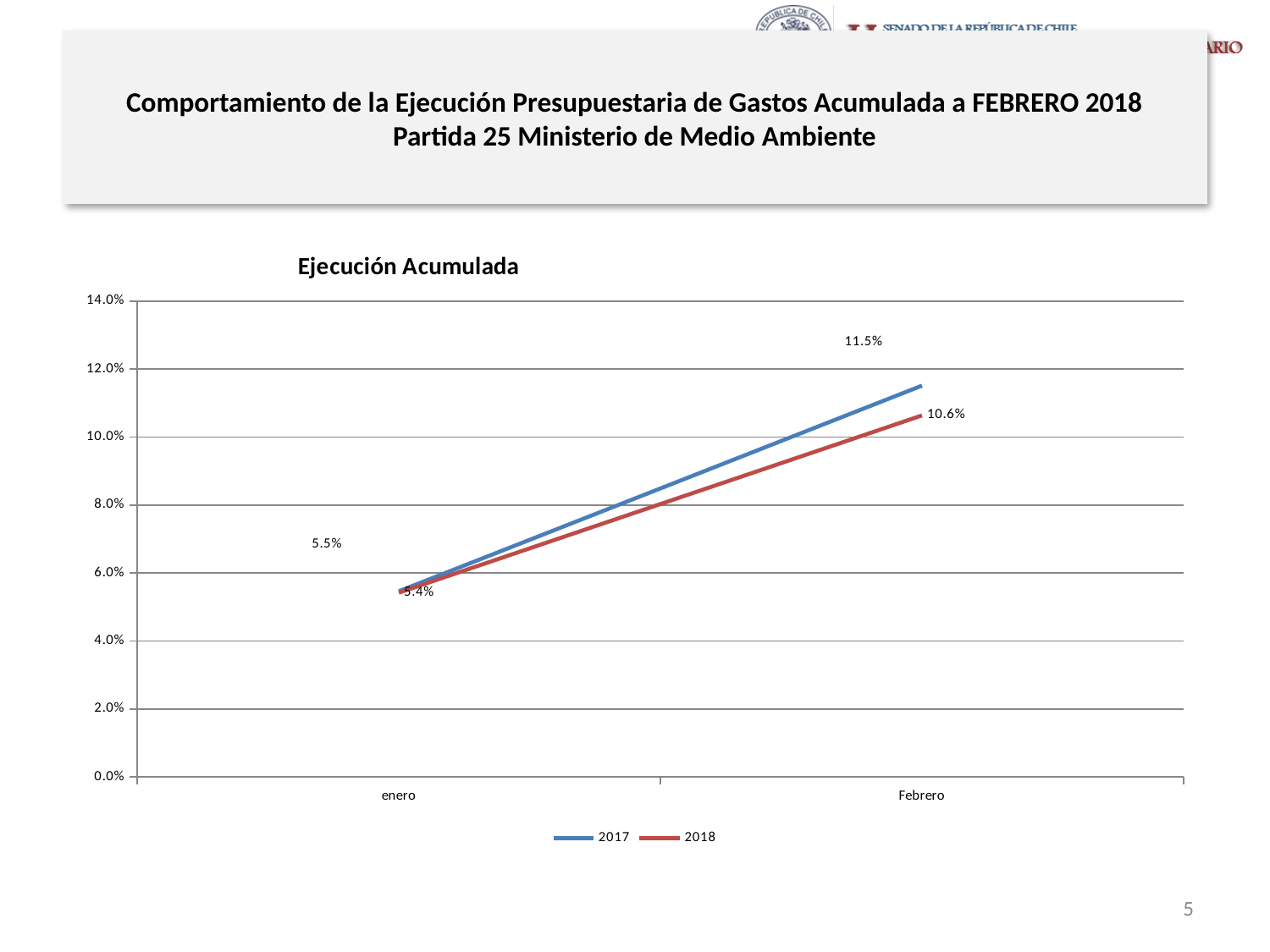
Do the values for the 2018 series rise or fall from enero to Febrero in the 'Ejecución Acumulada' chart? rise In Febrero, which series has the higher value in the 'Ejecución Acumulada' chart, 2017 or 2018? 2017 What is the difference between the 2017 and 2018 values in Febrero in the 'Ejecución Acumulada' chart? 0.9% What is the value for 2017 in enero in the 'Ejecución Acumulada' chart? 5.5% Is the value for 2018 in Febrero greater or less than 12.0% in the 'Ejecución Acumulada' chart? less How many series does the legend of the 'Ejecución Acumulada' chart list? 2 How many categories are shown on the x axis of the 'Ejecución Acumulada' chart? 2 What type of chart is shown under the title 'Ejecución Acumulada'? line chart Which series are listed in the legend of the 'Ejecución Acumulada' chart? 2017 and 2018 What is the value for 2018 in enero in the 'Ejecución Acumulada' chart? 5.4% What is the value for 2017 in Febrero in the 'Ejecución Acumulada' chart? 11.5% What is the value for 2018 in Febrero in the 'Ejecución Acumulada' chart? 10.6%